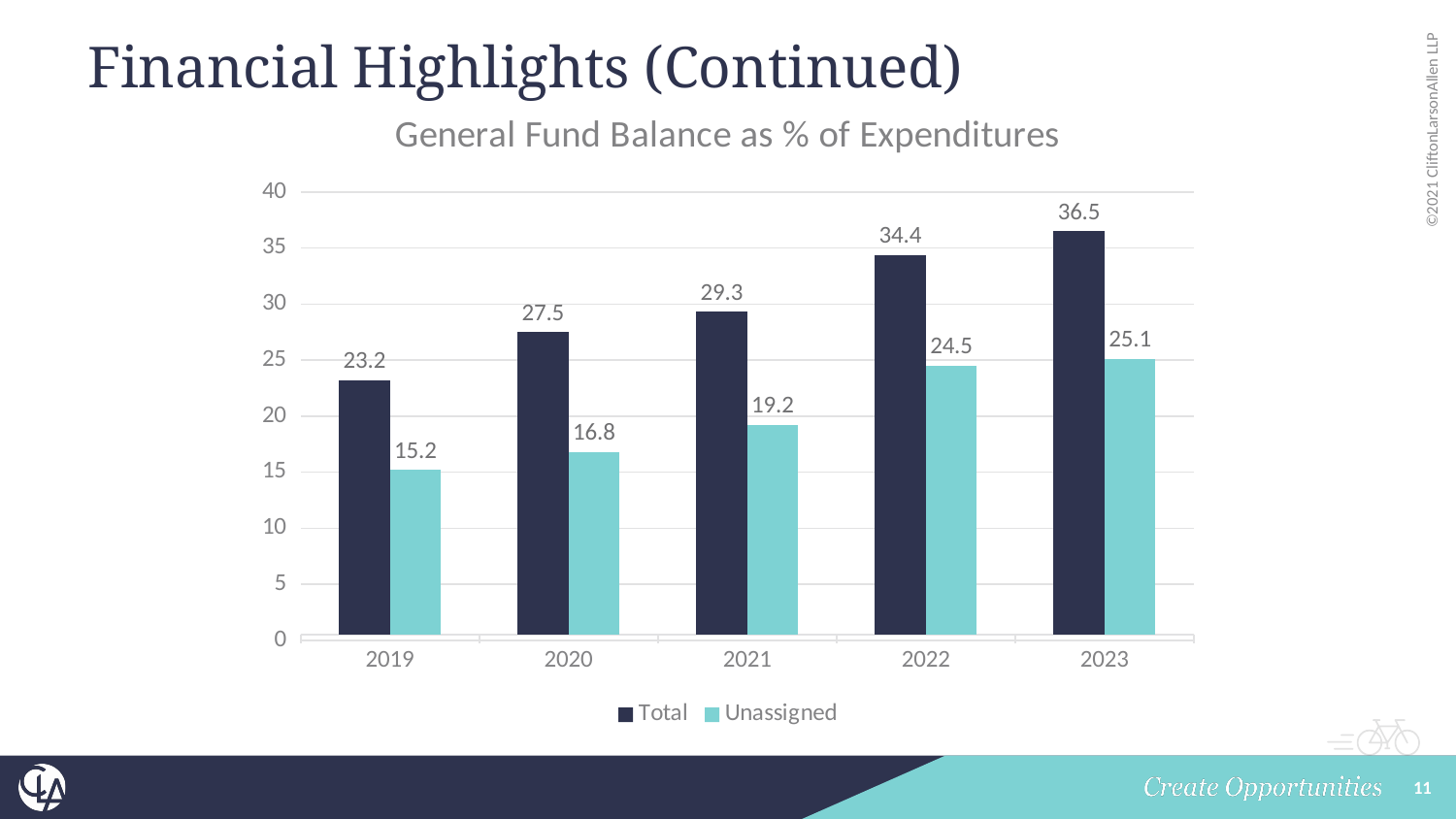
How many series does the legend list? 2 What kind of chart is shown on the slide? bar chart Do the Total values rise or fall from 2019 to 2023? rise Is the Unassigned value for 2021 greater or less than 20? less What is the difference between the Total and Unassigned values for 2022? 9.9 Which is larger, the Total value for 2020 or the Unassigned value for 2023? Total value for 2020 What is the Unassigned value for 2019? 15.2 Which year has the lowest Unassigned value? 2019 How many years are shown on the x axis? 5 Which year has the highest Total value? 2023 What is the Total value for 2021? 29.3 What is the Unassigned value for 2023? 25.1